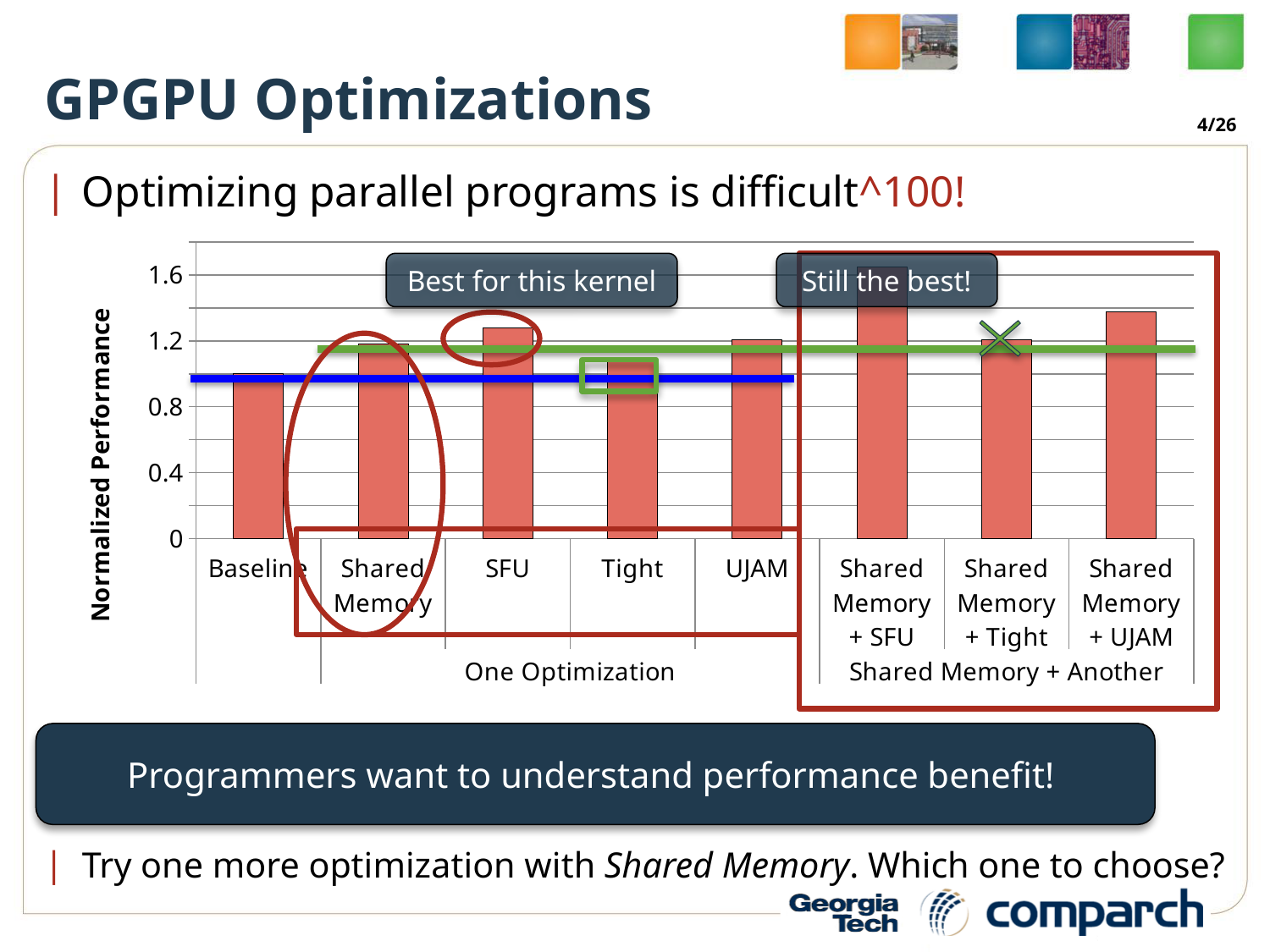
What are the two group labels shown beneath the category names on the x axis? One Optimization; Shared Memory + Another Is the value for Shared Memory + UJAM greater or less than 1.2? greater Is the value for Baseline greater or less than 1.2? less What is the title of the vertical axis of the chart? Normalized Performance Which has the higher normalized performance, SFU or Tight? SFU Which has the higher normalized performance, Shared Memory + SFU or Shared Memory + UJAM? Shared Memory + SFU Which category has the highest normalized performance? Shared Memory + SFU How many bars (categories) are plotted in the chart? 8 Is the value for Tight greater or less than 1.2? less Which has the higher normalized performance, Shared Memory + UJAM or SFU? Shared Memory + UJAM What kind of chart is shown on the slide? bar chart